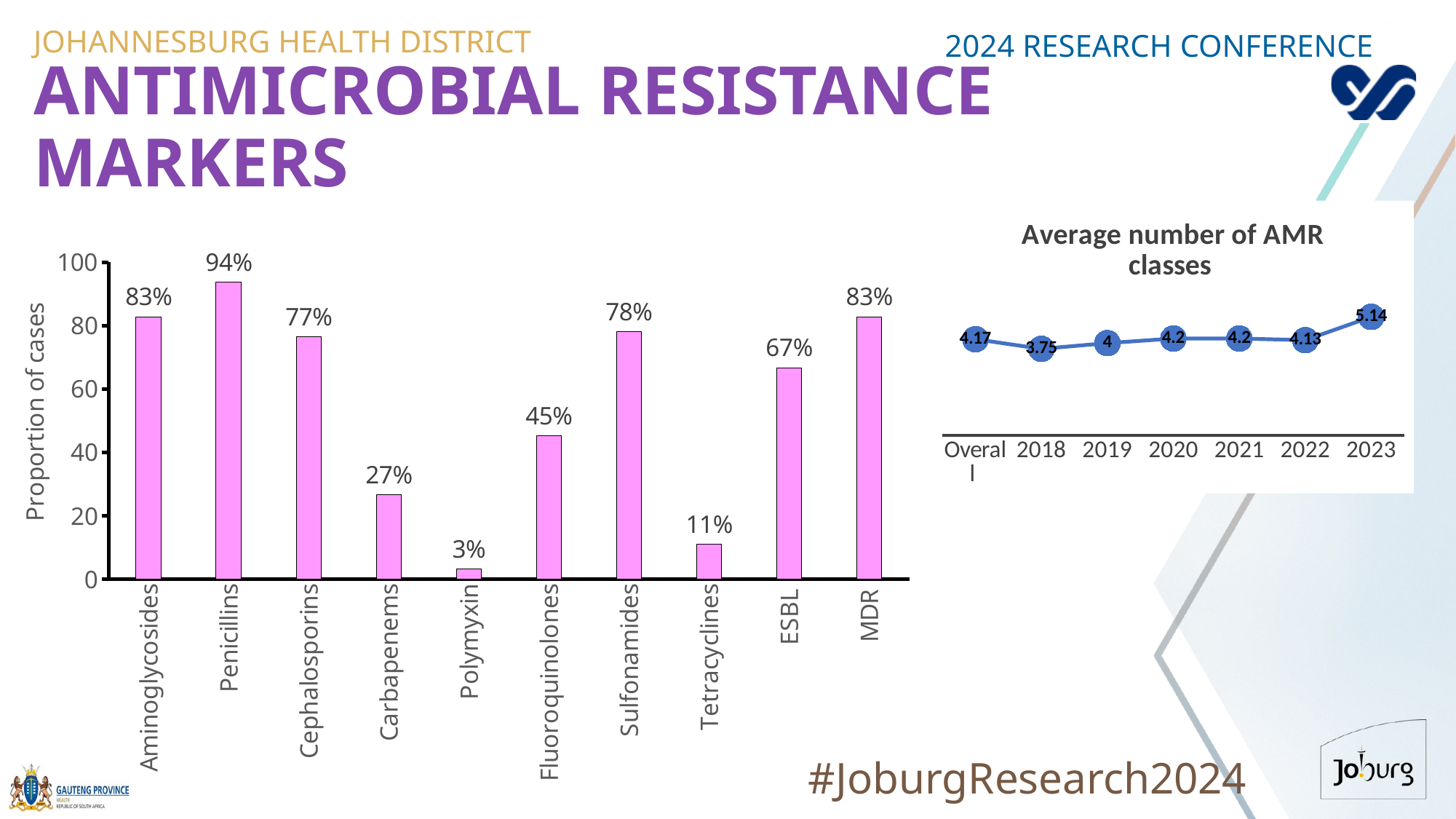
In the bar chart on the left, which category has the highest proportion of cases? Penicillins How many categories are shown in the bar chart on the left? 10 What kind of chart is the 'Average number of AMR classes' chart? Line chart In the 'Average number of AMR classes' chart, which year has the lowest value? 2018 In the bar chart on the left, what is the proportion of cases for Penicillins? 94% In the bar chart on the left, what is the proportion of cases for Carbapenems? 27% What kind of chart is the chart on the left? Bar chart In the bar chart on the left, what is the difference between the proportion of cases for Sulfonamides and Fluoroquinolones? 33% In the bar chart on the left, which is larger: the proportion of cases for ESBL or for Cephalosporins? Cephalosporins In the bar chart on the left, which category has the lowest proportion of cases? Polymyxin In the 'Average number of AMR classes' chart, what is the value for 2018? 3.75 In the 'Average number of AMR classes' chart, what is the value for 2023? 5.14